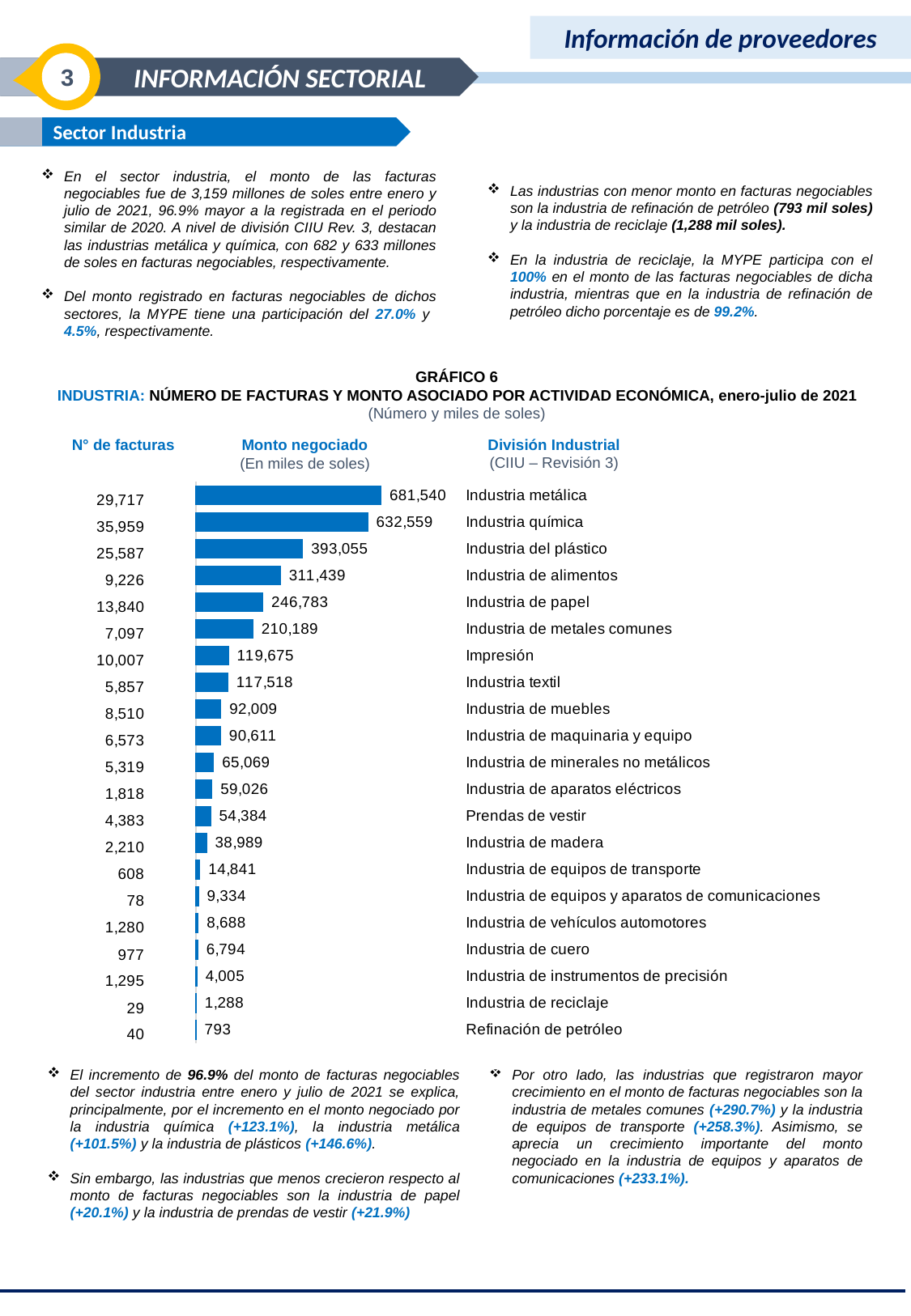
What is the N° de facturas shown for Industria de papel? 13,840 What is the monto negociado for Industria de reciclaje? 1,288 Which división industrial has the highest N° de facturas? Industria química Which división industrial has the highest monto negociado? Industria metálica In what units is the monto negociado expressed in the chart? En miles de soles Which división industrial has the lowest monto negociado? Refinación de petróleo Do the monto negociado values increase or decrease going from the top bar to the bottom bar? Decrease Which has a larger monto negociado, Industria de alimentos or Industria de papel? Industria de alimentos What is the difference in monto negociado between Industria metálica and Industria química? 48,981 What is the monto negociado (en miles de soles) for Industria del plástico? 393,055 How many divisiones industriales are shown in the chart? 21 What kind of chart is Gráfico 6? Bar chart